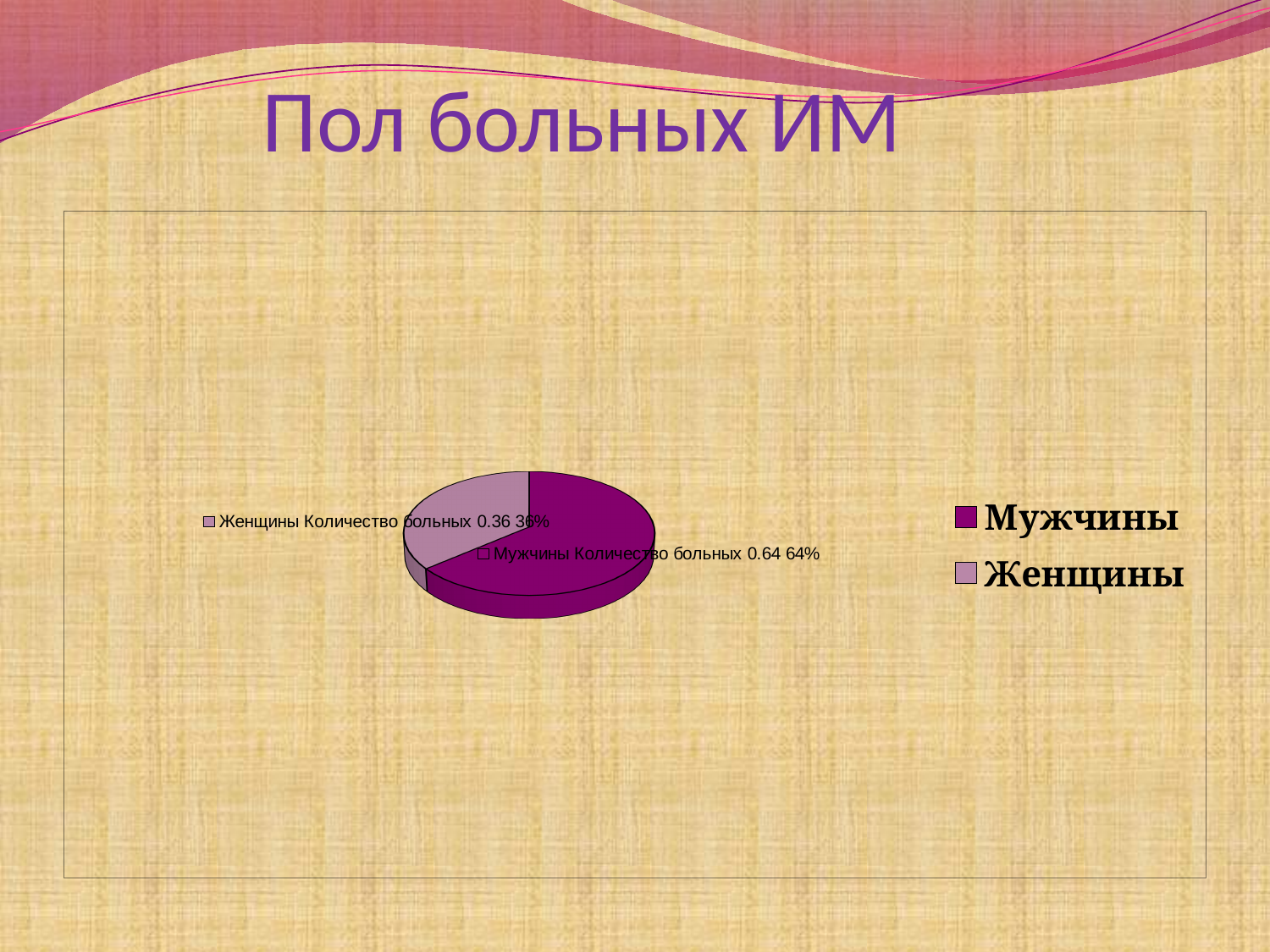
Which slice of the pie chart is the largest? Мужчины How many entries does the legend of the pie chart list? 2 What value is printed on the data label for Мужчины? 0.64 What share of the pie does the Женщины slice represent? 36% What share of the pie does the Мужчины slice represent? 64% What is the difference in percentage points between the Мужчины share and the Женщины share? 28% How many slices does the pie chart have? 2 What value is printed on the data label for Женщины? 0.36 Which is larger, the share for Мужчины or the share for Женщины? Мужчины Which slice of the pie chart is the smallest? Женщины What is the title of the slide with the pie chart? Пол больных ИМ What kind of chart is shown on the slide? pie chart